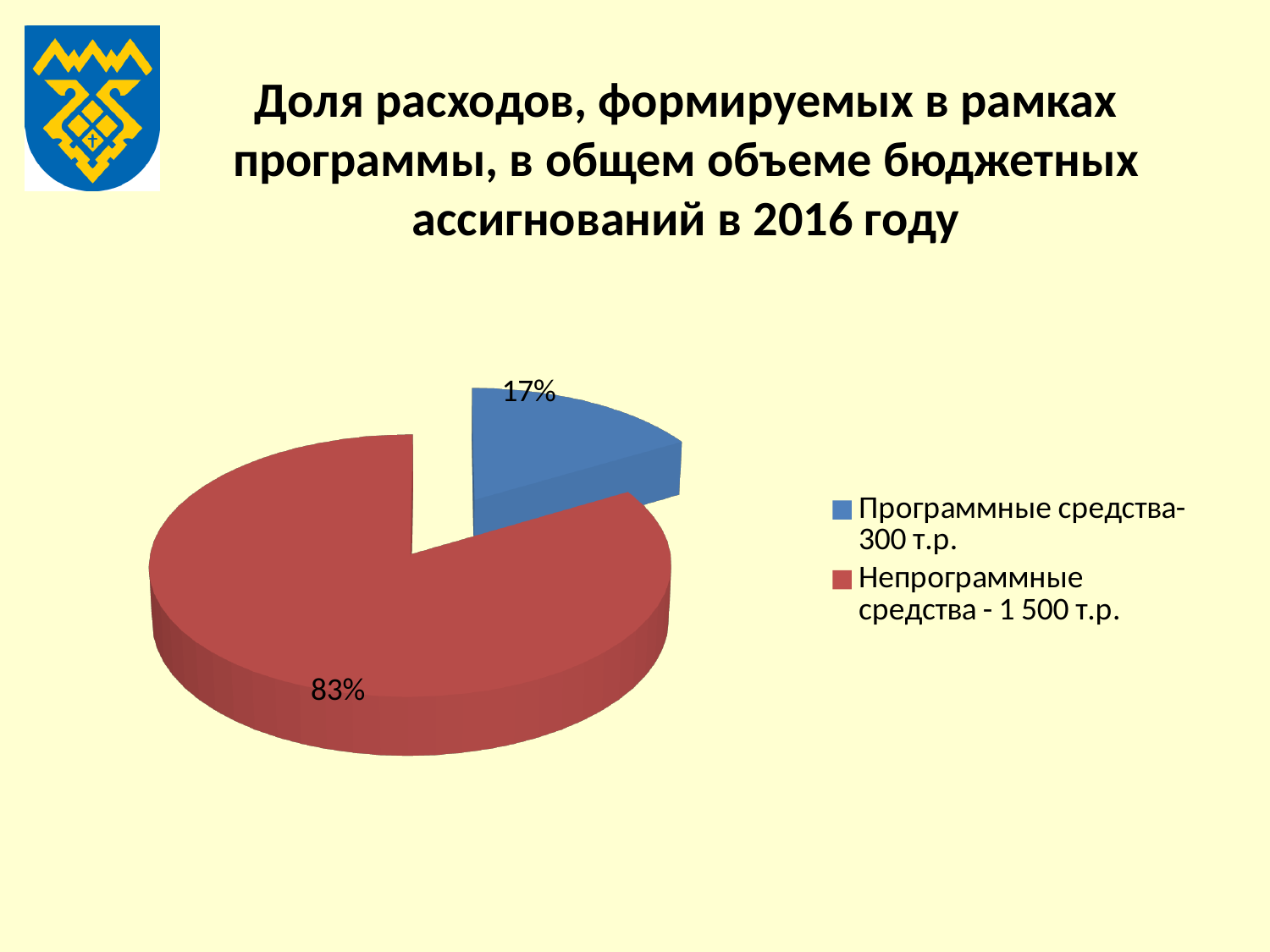
Which slice of the pie is the largest? Непрограммные средства - 1 500 т.р. How many slices does the pie chart have? 2 What is the difference in percentage points between the "Непрограммные средства" slice and the "Программные средства" slice? 66 How many entries does the legend list? 2 Which is larger: the share for "Программные средства" or the share for "Непрограммные средства"? Непрограммные средства What share of the pie does "Программные средства- 300 т.р." take? 17% What kind of chart is shown on the slide? pie chart Which slice of the pie is the smallest? Программные средства- 300 т.р. What colour is the slice for "Непрограммные средства"? red What share of the pie does "Непрограммные средства - 1 500 т.р." take? 83% What amount in т.р. is given in the legend for "Программные средства"? 300 т.р. What amount in т.р. is given in the legend for "Непрограммные средства"? 1 500 т.р.